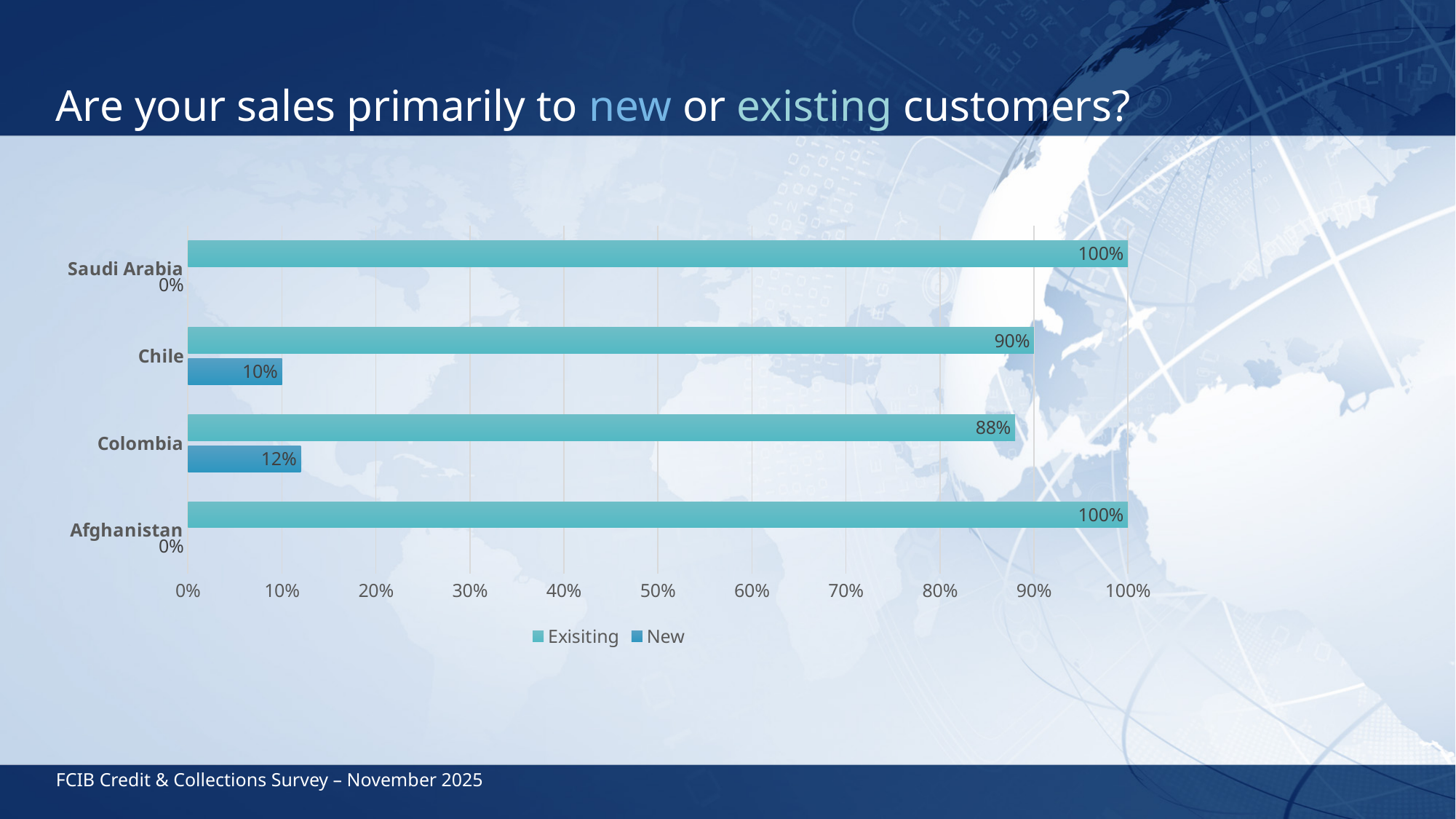
How many countries are shown on the chart? 4 What is the Exisiting value for Chile? 90% How many series does the legend list? 2 What is the Exisiting value for Colombia? 88% Which is larger, the New value for Chile or the New value for Colombia? Colombia Is the Exisiting value for Colombia greater or less than 80%? greater Which country has the lowest Exisiting value? Colombia Which country has the highest New value? Colombia What is the New value for Saudi Arabia? 0% What is the New value for Colombia? 12% What kind of chart is shown on the slide? Bar chart What is the difference between the Exisiting values for Chile and Colombia? 2%